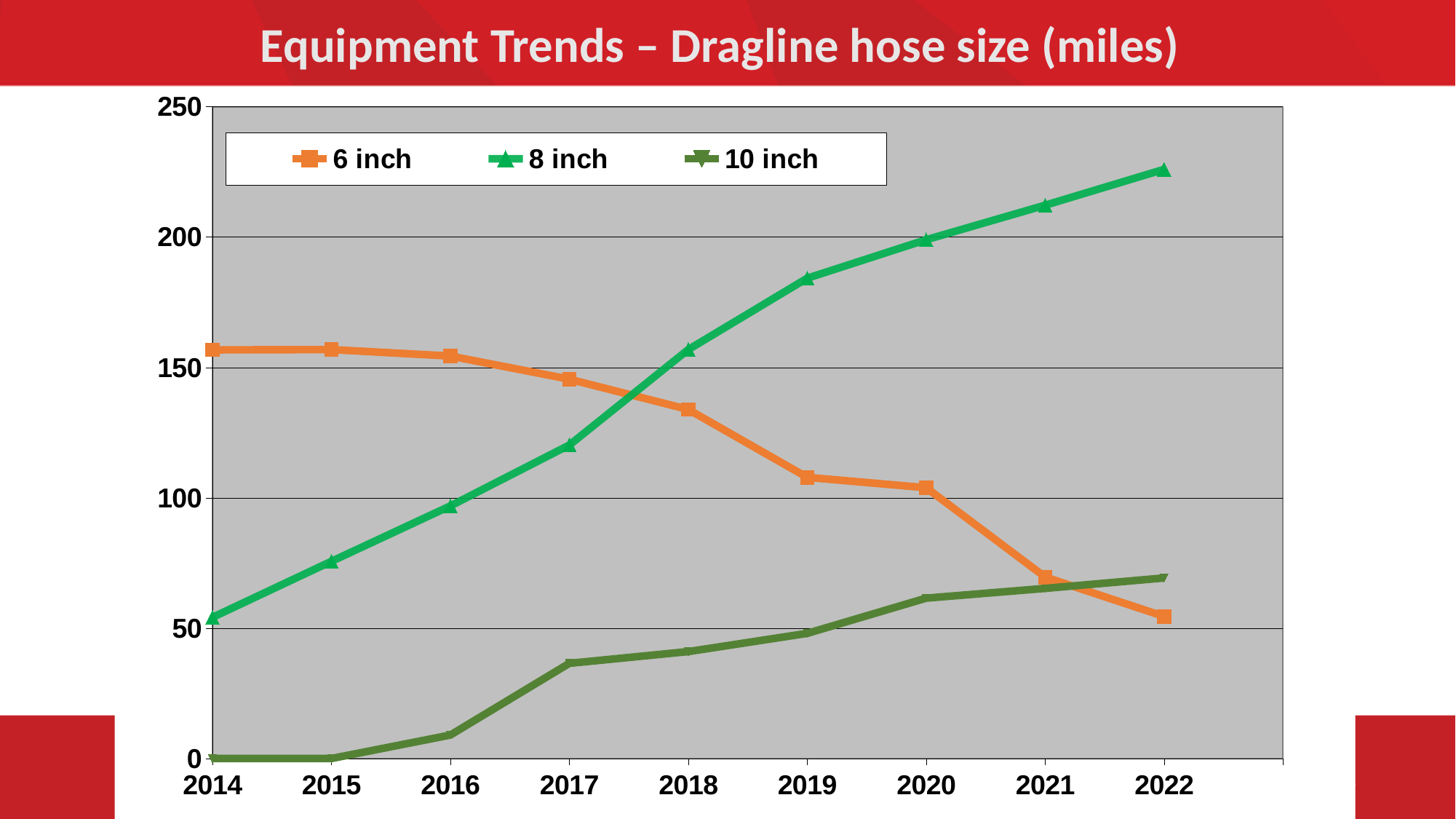
How many years are plotted along the x axis? 9 Is the value for 8 inch in 2022 greater or less than 200? greater Does the 8 inch series rise or fall from 2014 to 2022? rise Does the 6 inch series rise or fall from 2014 to 2022? fall What kind of chart is shown on the slide? line chart Which series has the highest value in 2022? 8 inch What is the title of the chart? Equipment Trends – Dragline hose size (miles) Which series has the lowest value in 2014? 10 inch How many series does the legend list? 3 Is the value for 6 inch in 2014 greater or less than 150? greater In 2018, which series has the larger value, 6 inch or 8 inch? 8 inch Is the value for 10 inch in 2017 greater or less than 50? less